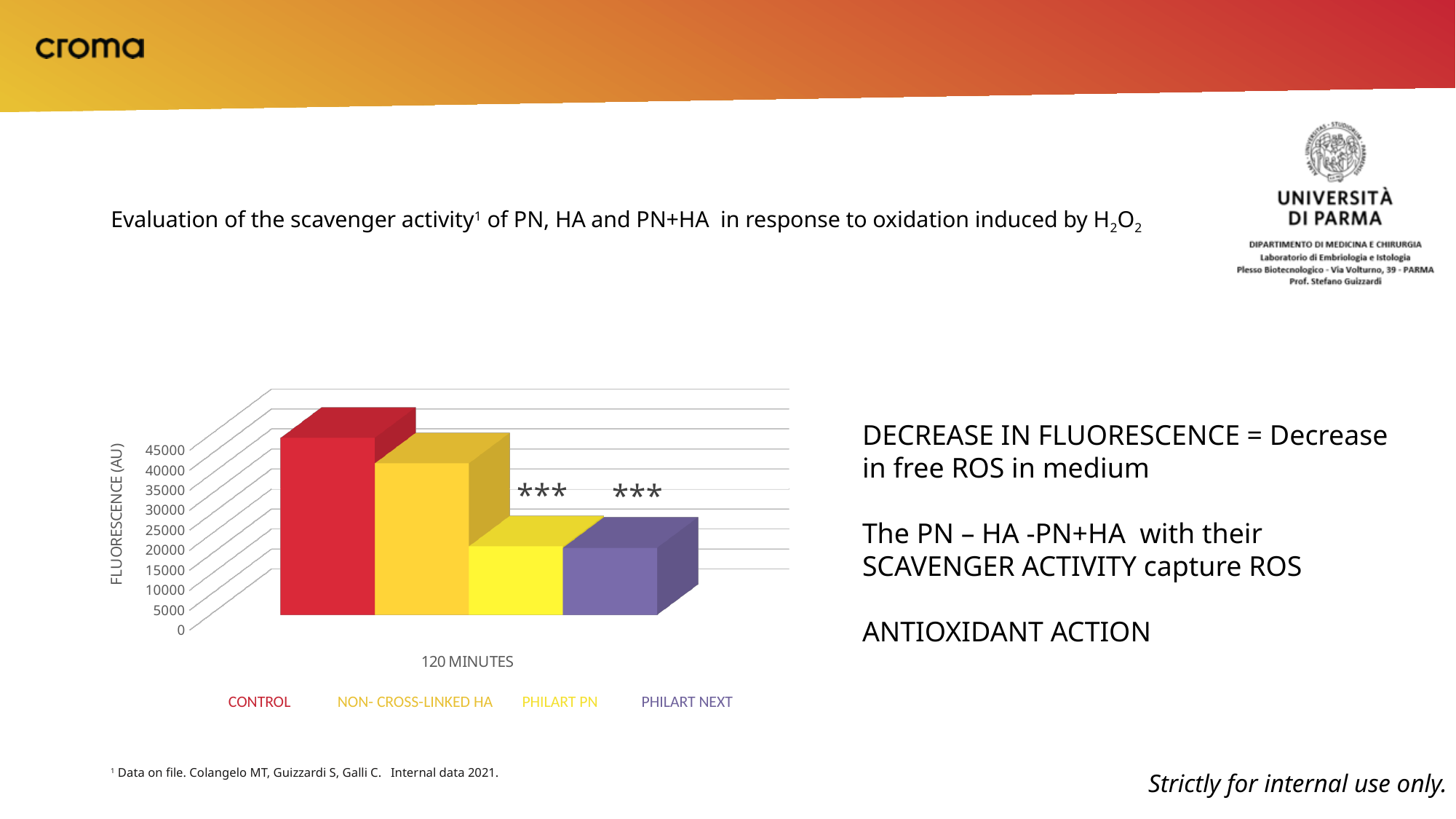
What is the label on the vertical axis of the chart? FLUORESCENCE (AU) Is the value for PHILART NEXT greater or less than 30000? less Which series has the highest fluorescence value in the chart? CONTROL Is the value for NON- CROSS-LINKED HA greater or less than 25000? greater Which is larger, the value for NON- CROSS-LINKED HA or the value for PHILART NEXT? NON- CROSS-LINKED HA What is the category label shown on the x axis of the chart? 120 MINUTES How many categories are shown on the x axis of the chart? 1 What kind of chart is shown on the slide? bar chart Is the value for PHILART PN greater or less than 30000? less How many series does the chart legend list? 4 Which is larger, the value for CONTROL or the value for PHILART PN? CONTROL